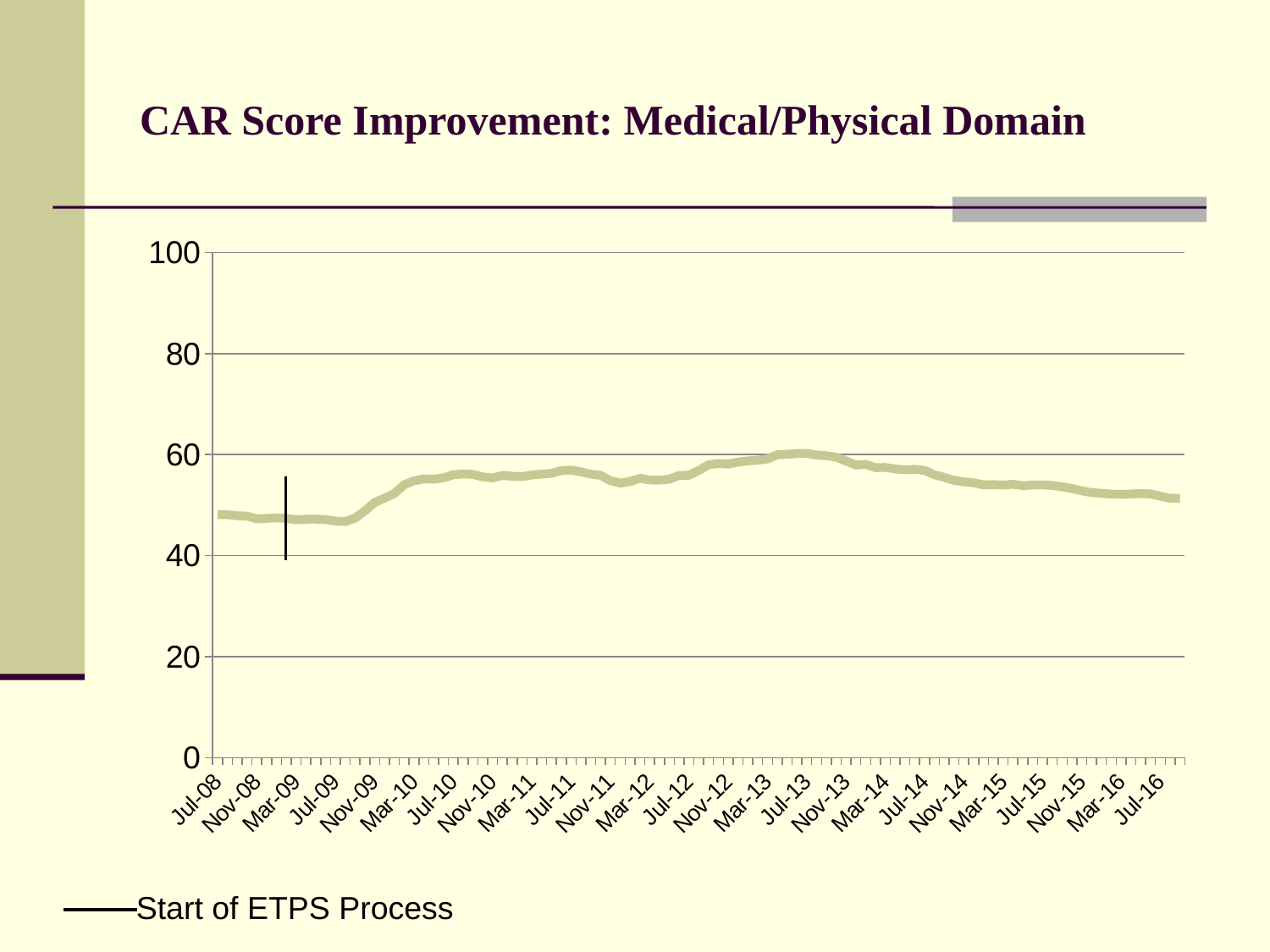
Which has the larger value, Jul-08 or Jul-10? Jul-10 What is the title of the chart? CAR Score Improvement: Medical/Physical Domain What kind of chart is shown on the slide? Line chart How many date labels are shown on the x axis? 25 Is the value for Jul-13 greater or less than 80? less What does the vertical black line marker in the chart represent, according to the legend? Start of ETPS Process Is the value for Jul-08 greater or less than 40? greater Does the line generally rise or fall between Jul-09 and Jul-13? Rise Is the value for Jul-16 greater or less than 40? greater Which has the larger value, Jul-08 or Jul-13? Jul-13 Does the line generally rise or fall between Jul-13 and Jul-16? Fall